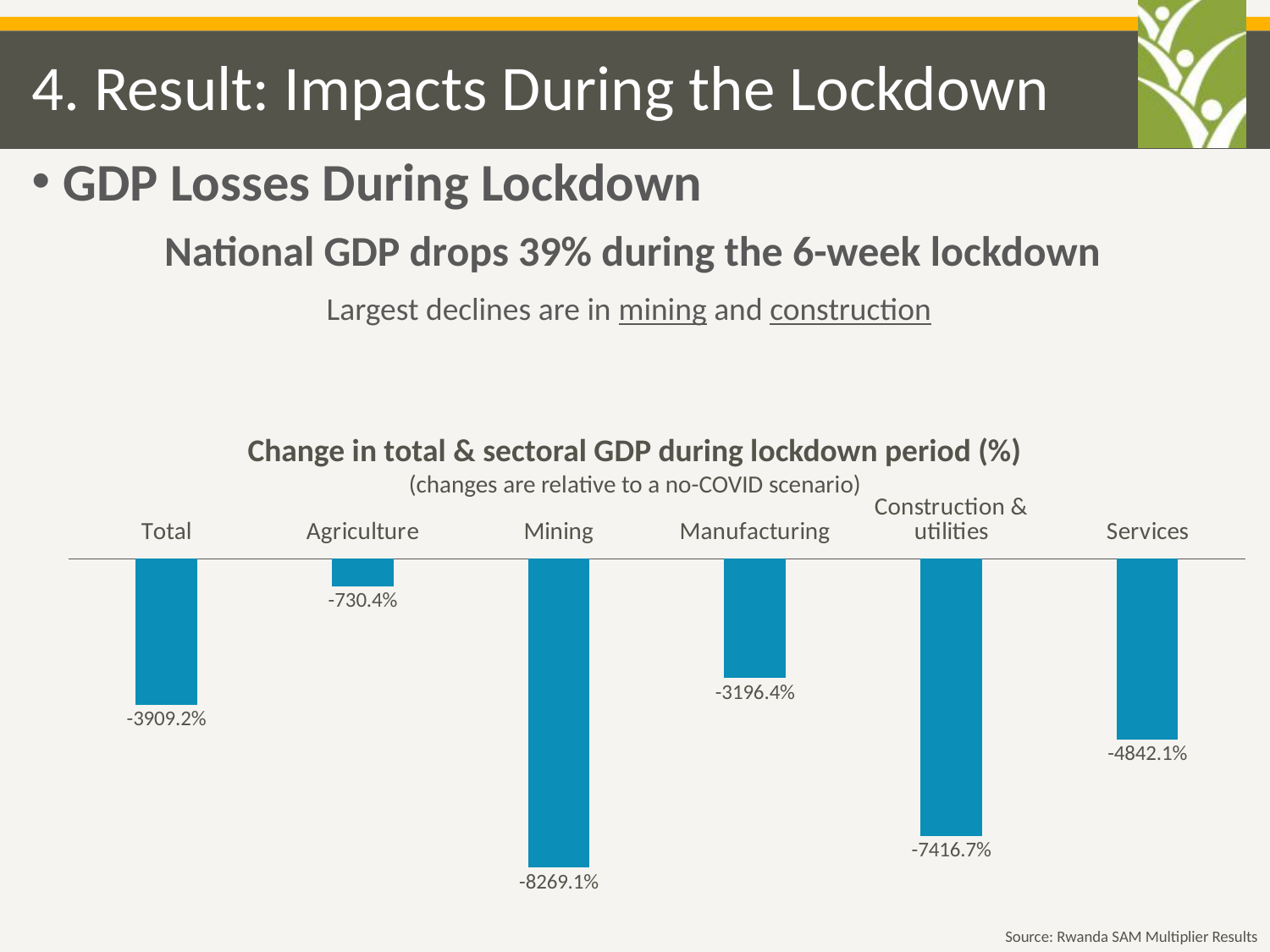
Which category shows the smallest decline (least negative value) in the chart? Agriculture What is the value shown for Mining in the chart? -8269.1% What is the value shown for Services in the chart? -4842.1% What is the title of the chart? Change in total & sectoral GDP during lockdown period (%) What is the value shown for Construction & utilities in the chart? -7416.7% What is the value shown for Agriculture in the chart? -730.4% By how many percentage points does the decline for Mining exceed the decline for Construction & utilities? 852.4 What type of chart is shown on the slide? Bar chart What is the difference between the Total value and the Manufacturing value? 712.8 percentage points Which category shows the largest decline (most negative value) in the chart? Mining Which has a larger decline, Services or Manufacturing? Services How many categories are plotted in the chart? 6